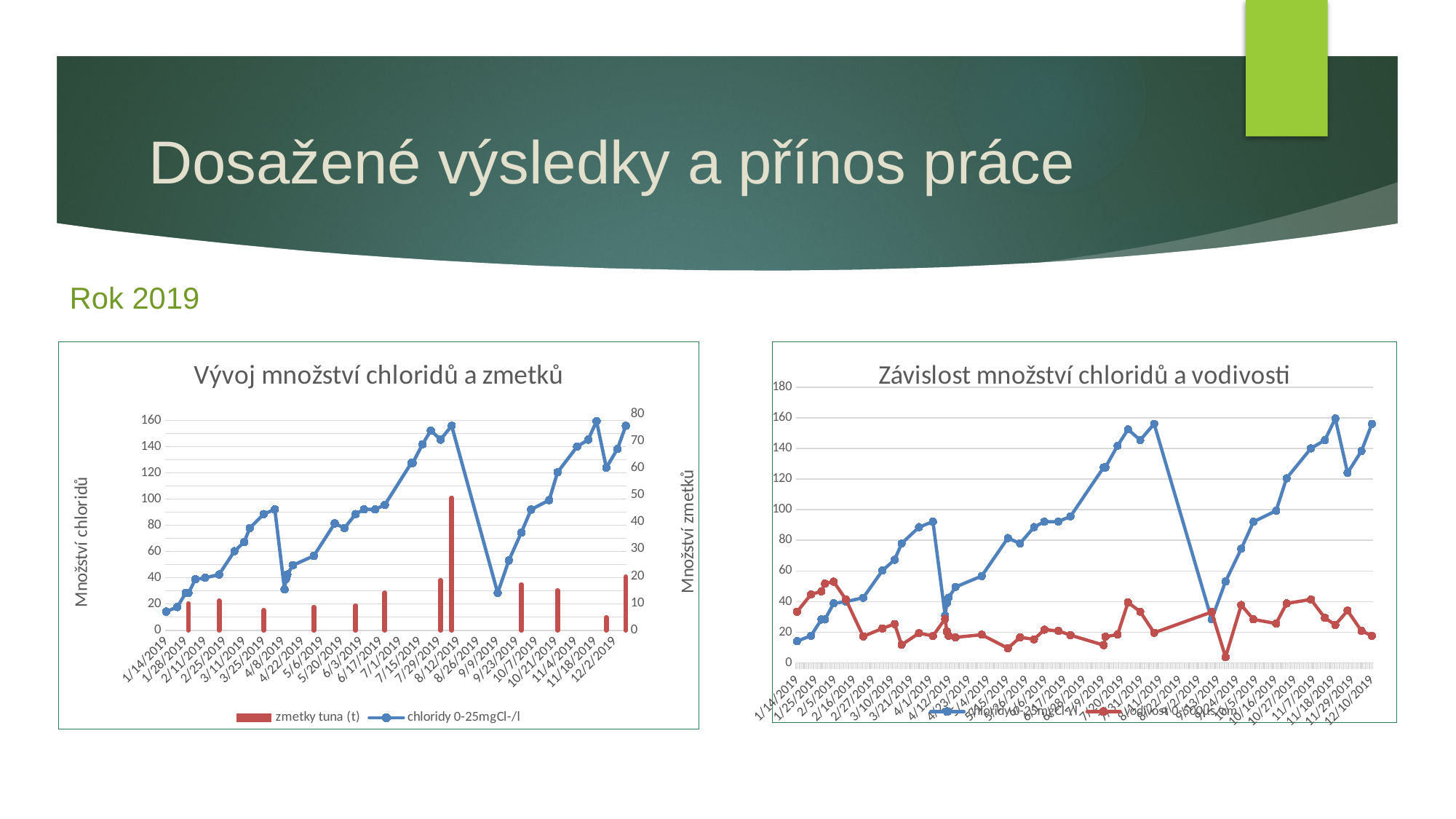
What is the title of the right-hand axis of the left chart "Vývoj množství chloridů a zmetků"? Množství zmetků What kind of chart is the left chart titled "Vývoj množství chloridů a zmetků"? A combination of a bar chart and a line chart What kind of chart is the right chart titled "Závislost množství chloridů a vodivosti"? Line chart How many series does the legend of the left chart "Vývoj množství chloridů a zmetků" list? 2 In the right chart "Závislost množství chloridů a vodivosti", which series is larger on 11/18/2019, chloridy or vodivost? chloridy In the left chart "Vývoj množství chloridů a zmetků", is the zmetky bar on 8/12/2019 greater or less than 40 on the right axis? greater In the left chart "Vývoj množství chloridů a zmetků", is the chloridy value on 8/12/2019 greater or less than 140? greater In the right chart "Závislost množství chloridů a vodivosti", is the chloridy value on 1/14/2019 greater or less than 20? less In the left chart "Vývoj množství chloridů a zmetků", which series is drawn as bars? zmetky tuna (t) In the left chart "Vývoj množství chloridů a zmetků", does the chloridy line rise or fall between 1/14/2019 and 3/25/2019? rise